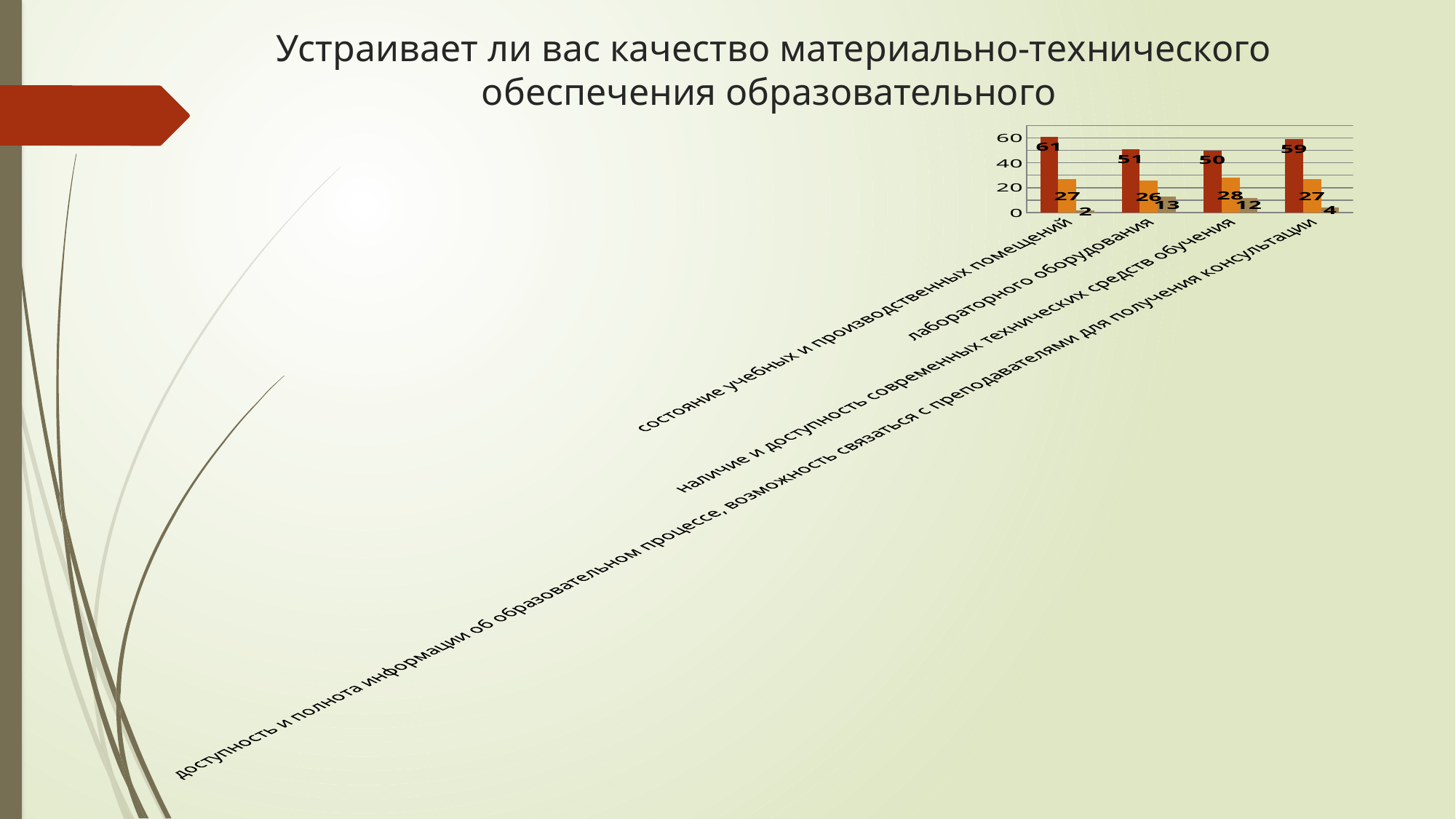
What is the value of the dark red bar for 'доступность и полнота информации об образовательном процессе, возможность связаться с преподавателями для получения консультации'? 59 Which category has the lowest brown bar? состояние учебных и производственных помещений What is the value of the brown bar for 'наличие и доступность современных технических средств обучения'? 12 What is the value of the dark red bar for 'состояние учебных и производственных помещений'? 61 Which category has the highest dark red bar? состояние учебных и производственных помещений Is the dark red bar for 'наличие и доступность современных технических средств обучения' greater or less than 40? greater How many categories are shown on the x axis of the chart? 4 How many bars are shown for each category in the chart? 3 What kind of chart is shown on the slide? bar chart